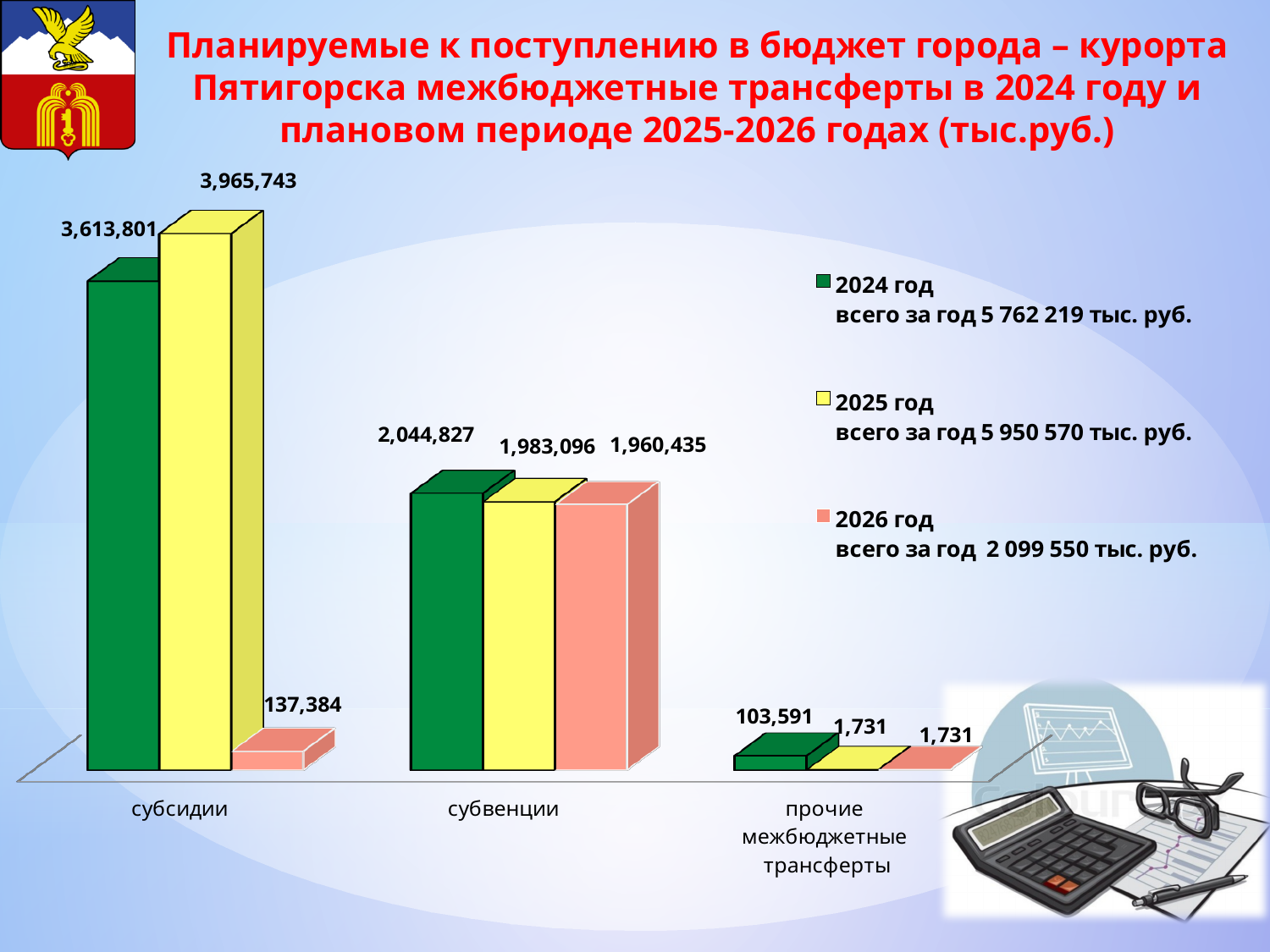
How many series does the legend list? 3 What is the value for субсидии in the 2024 год series? 3,613,801 Which category has the highest value in the 2025 год series? субсидии Which category has the lowest value in the 2026 год series? прочие межбюджетные трансферты What is the value for субсидии in the 2025 год series? 3,965,743 What is the value for прочие межбюджетные трансферты in the 2024 год series? 103,591 How many categories are shown on the x axis? 3 What is the value for субвенции in the 2026 год series? 1,960,435 What kind of chart is shown on the slide? bar chart What is the difference between the 2025 год and 2024 год values for субсидии? 351,942 Which is larger for субвенции: the 2024 год value or the 2025 год value? 2024 год According to the legend, what is the total for 2025 год? 5 950 570 тыс. руб.